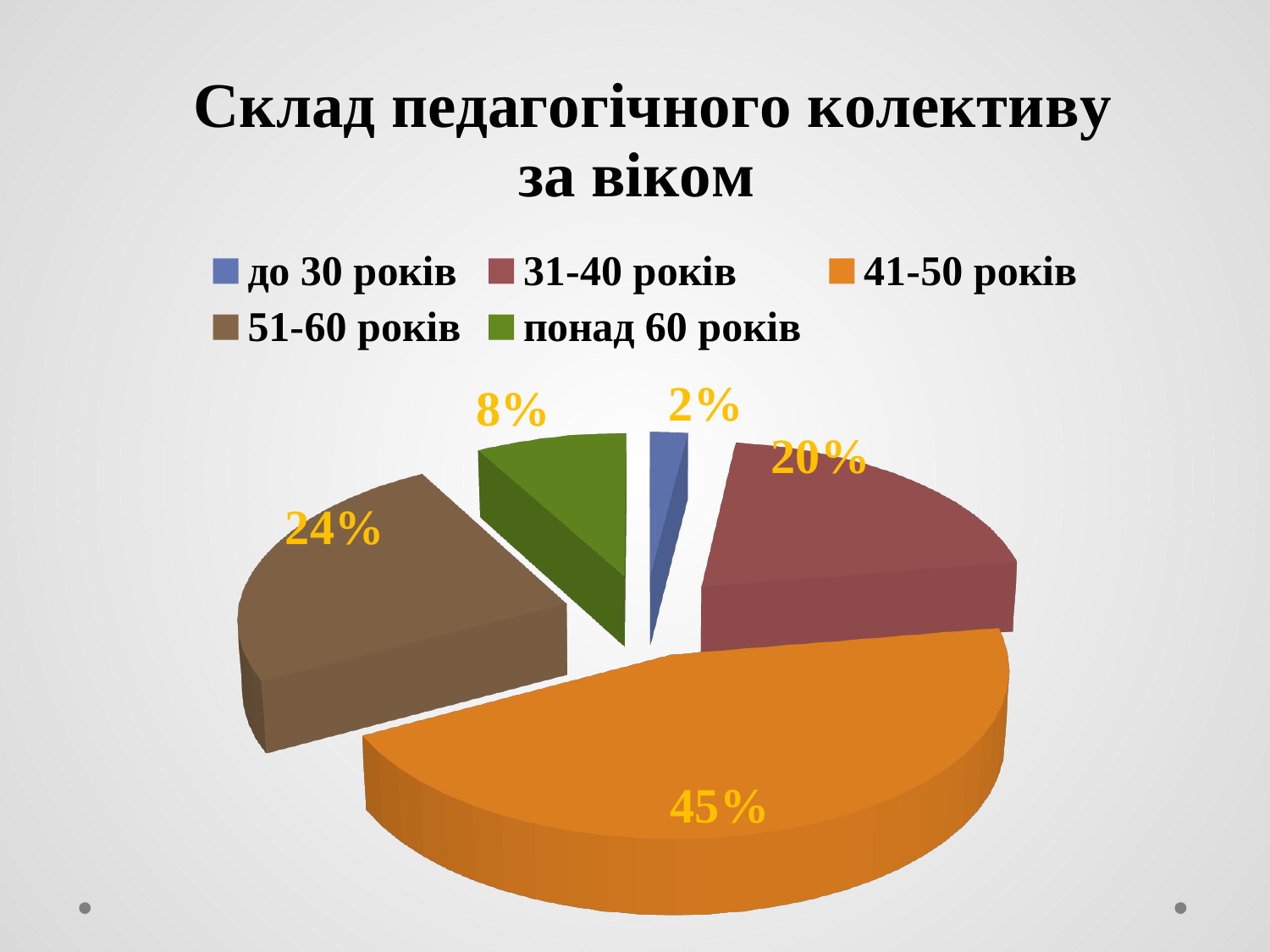
What share of the pie does the 41-50 років slice represent? 45% What is the value shown for до 30 років? 2% What is the value shown for 51-60 років? 24% Which age group has the smallest share? до 30 років What is the title of the chart? Склад педагогічного колективу за віком What kind of chart is shown on the slide? Pie chart What is the value shown for 31-40 років? 20% How many age categories are shown in the pie chart? 5 What is the difference between the shares of 41-50 років and 51-60 років? 21% Which is larger, the share for 31-40 років or the share for понад 60 років? 31-40 років What is the value shown for понад 60 років? 8% Which age group has the largest share? 41-50 років